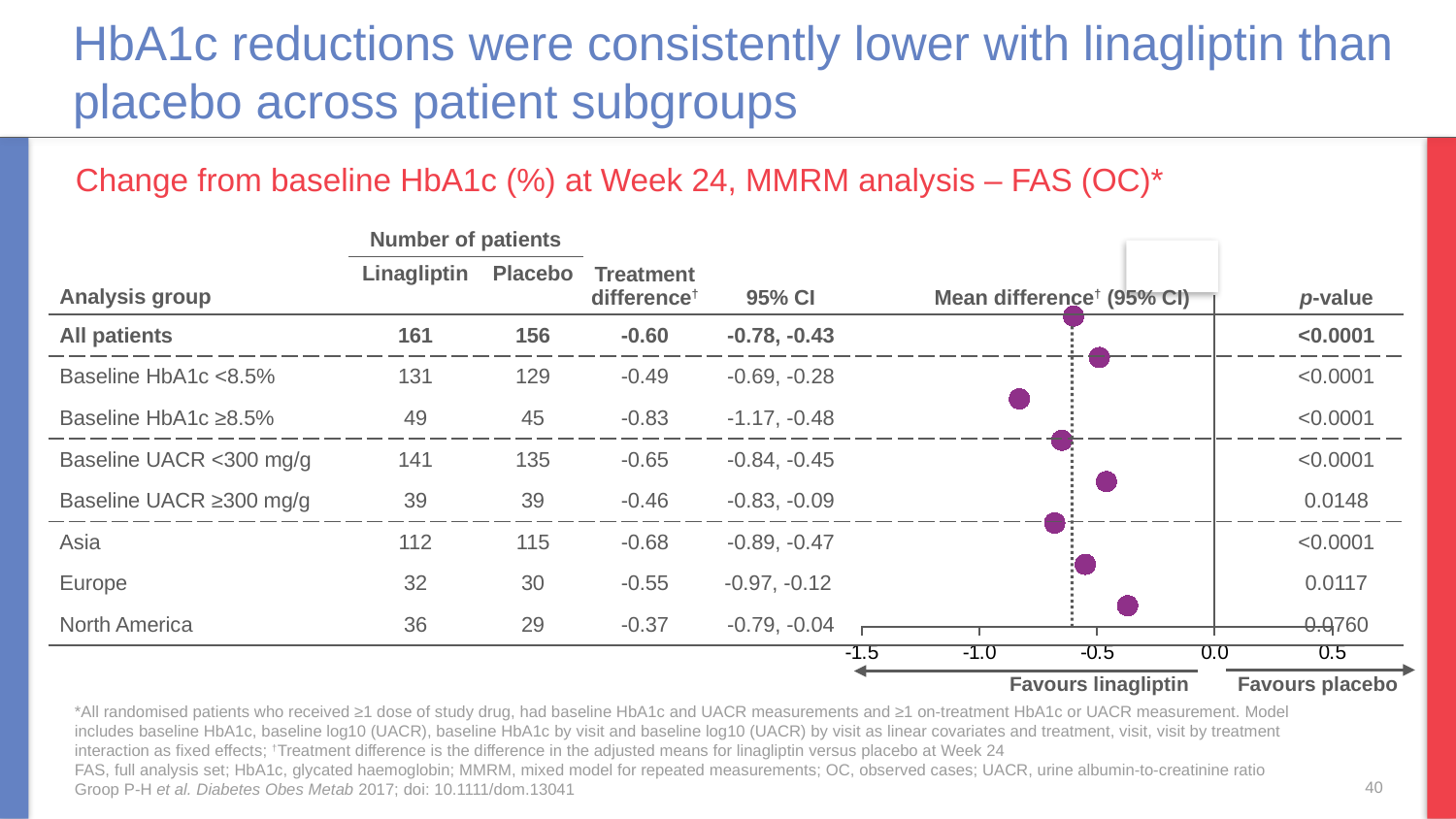
What kind of chart is used to display the mean differences? Forest plot How many analysis groups are plotted as points in the forest plot? 8 What is the difference between the treatment differences for Asia and North America? 0.31 Which analysis group has the most negative (largest) mean difference in the forest plot? Baseline HbA1c ≥8.5% What is the p-value for the Baseline UACR ≥300 mg/g subgroup? 0.0148 What is the 95% CI for the Baseline HbA1c ≥8.5% subgroup? -1.17, -0.48 What is the mean treatment difference plotted for the All patients group? -0.60 What does the left side of the x axis favour, according to the label under the plot? Favours linagliptin What is the treatment difference for the North America subgroup? -0.37 Which subgroup has a larger HbA1c reduction (more negative mean difference): Baseline UACR <300 mg/g or Baseline UACR ≥300 mg/g? Baseline UACR <300 mg/g Is the mean difference for the Europe subgroup greater or less than 0.0? less Which analysis group has the mean difference closest to zero in the forest plot? North America